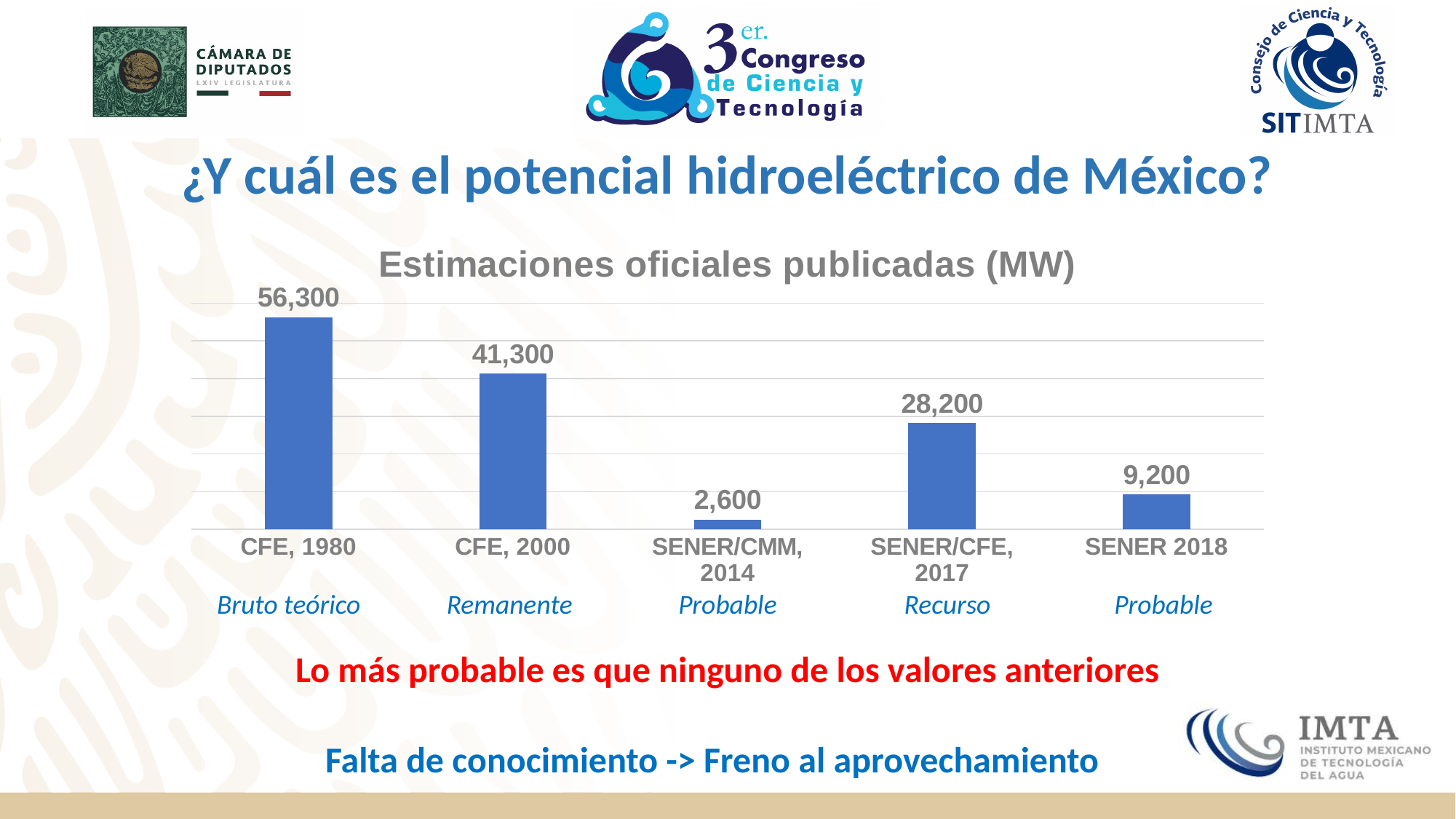
What is the difference between the values for CFE, 1980 and CFE, 2000? 15,000 What colour are the bars in the chart? Blue Which category has the lowest value? SENER/CMM, 2014 What is the title of the chart? Estimaciones oficiales publicadas (MW) What is the value for SENER 2018? 9,200 What is the value for CFE, 1980? 56,300 Which category has the highest value? CFE, 1980 Which is larger, the value for CFE, 2000 or the value for SENER/CFE, 2017? CFE, 2000 What is the value for SENER/CMM, 2014? 2,600 How many categories are shown in the chart? 5 What kind of chart is shown on the slide? Bar chart What is the difference between the values for SENER/CFE, 2017 and SENER 2018? 19,000